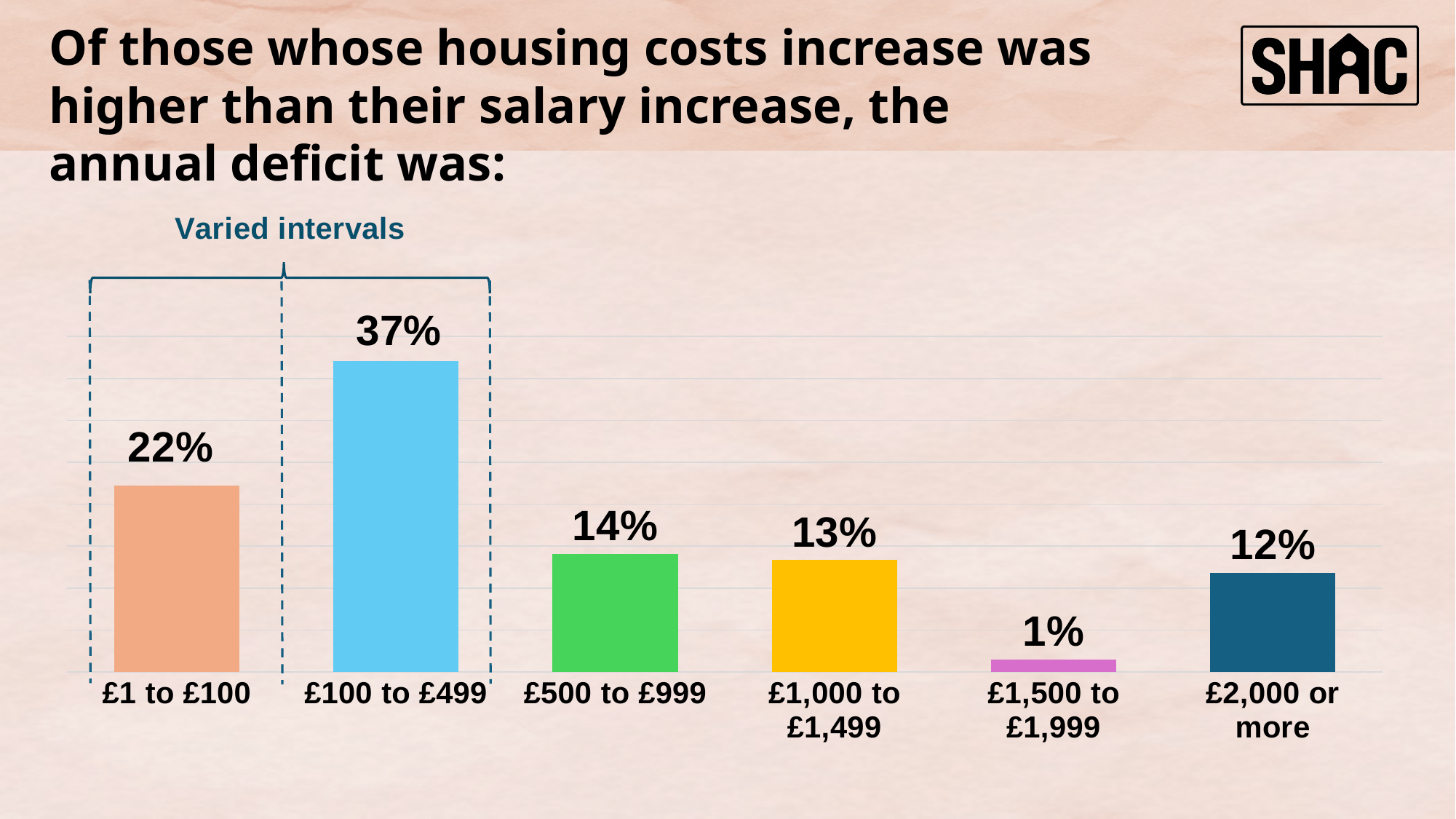
What is the combined percentage of the £1 to £100 and £100 to £499 categories? 59% What percentage of respondents had an annual deficit of £100 to £499? 37% What percentage is shown for the £2,000 or more category? 12% What label appears above the bracket covering the first two bars? Varied intervals What is the value shown for the £1 to £100 category? 22% What is the value for the £1,500 to £1,999 category? 1% Which is larger, the value for £500 to £999 or the value for £1,000 to £1,499? £500 to £999 Which deficit category has the lowest percentage? £1,500 to £1,999 Which deficit category has the highest percentage? £100 to £499 What is the difference in percentage points between the £100 to £499 and £1 to £100 categories? 15 How many deficit categories are shown in the chart? 6 What kind of chart is shown on the slide? Bar chart